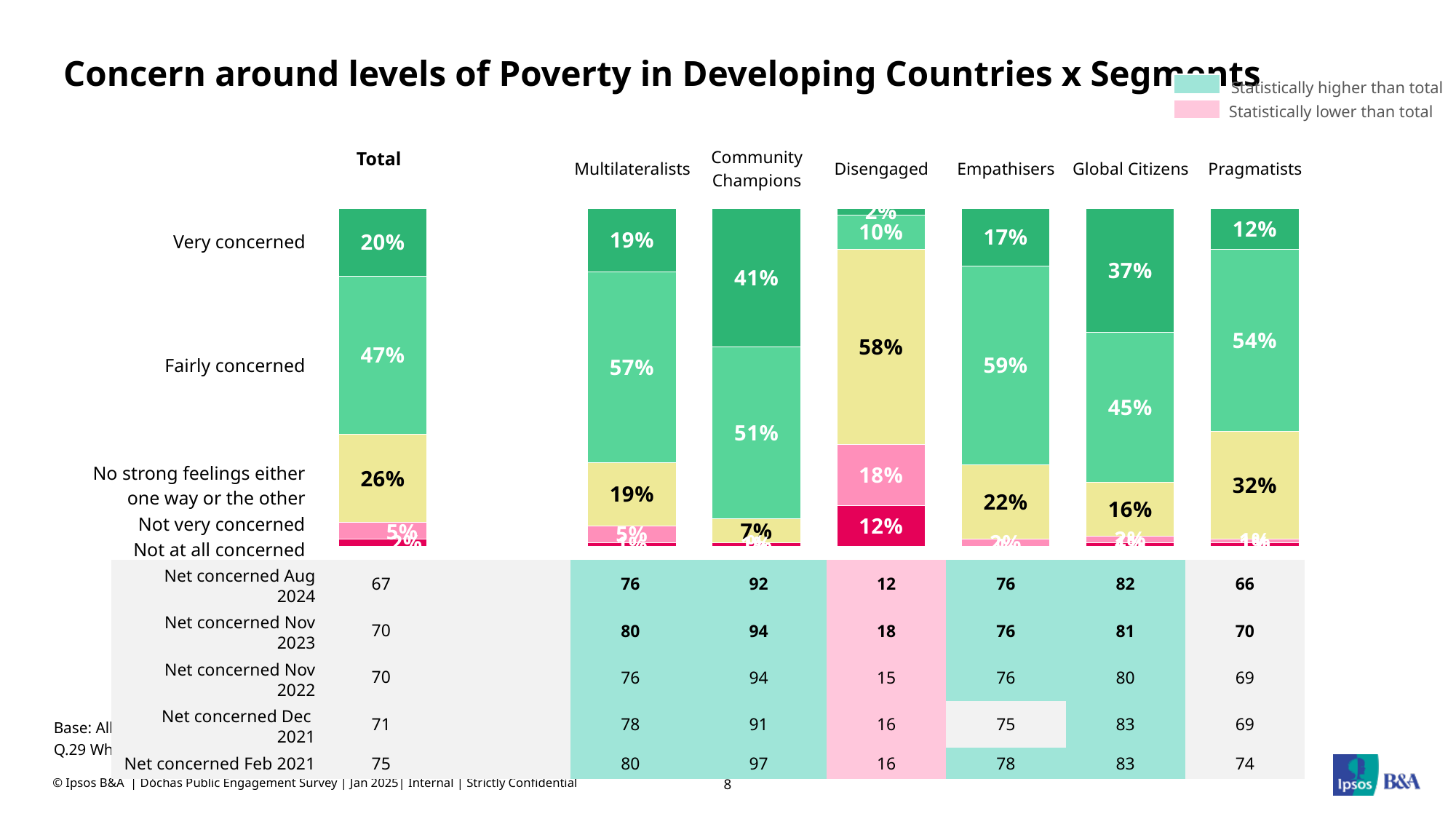
What percentage of Empathisers are Fairly concerned? 59% Which segment has the lowest Fairly concerned percentage? Disengaged What percentage of the Disengaged segment have no strong feelings either one way or the other? 58% Which segment has the highest Very concerned percentage? Community Champions How many bars are shown in the chart? 7 What is the difference between the Fairly concerned percentages for Multilateralists and Global Citizens? 12% What type of chart is shown on the slide? Stacked bar chart What percentage of Community Champions are Very concerned? 41% What is the Not very concerned percentage for the Disengaged segment? 18% What percentage of Pragmatists have no strong feelings either one way or the other? 32% Which is larger: the Very concerned percentage for Global Citizens or for Empathisers? Global Citizens What percentage of the Total are Very concerned? 20%